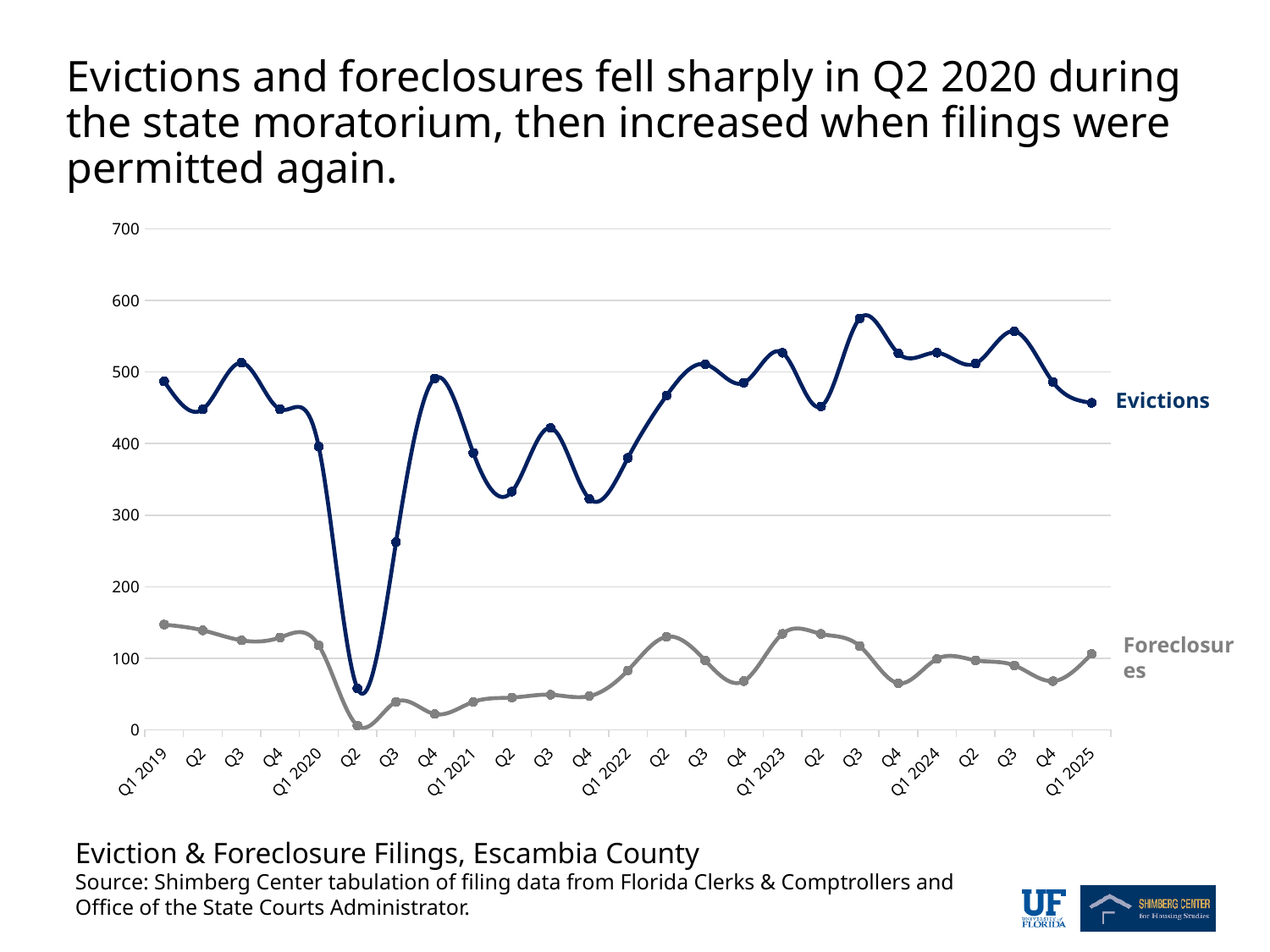
Is the value for Evictions in Q3 2023 greater or less than 500? greater Which quarter has the lowest value for Evictions? Q2 2020 Do Evictions rise or fall from Q1 2020 to Q2 2020? fall Is the value for Evictions in Q1 2019 greater or less than 400? greater How many quarterly data points does each line have, from Q1 2019 to Q1 2025? 25 What kind of chart is shown on the slide? line chart Is the value for Foreclosures in Q4 2023 greater or less than 100? less What is the title of the chart given below the plot? Eviction & Foreclosure Filings, Escambia County In Q1 2019, which series has the larger value, Evictions or Foreclosures? Evictions Which quarter has the lowest value for Foreclosures? Q2 2020 How many series are plotted on the chart? 2